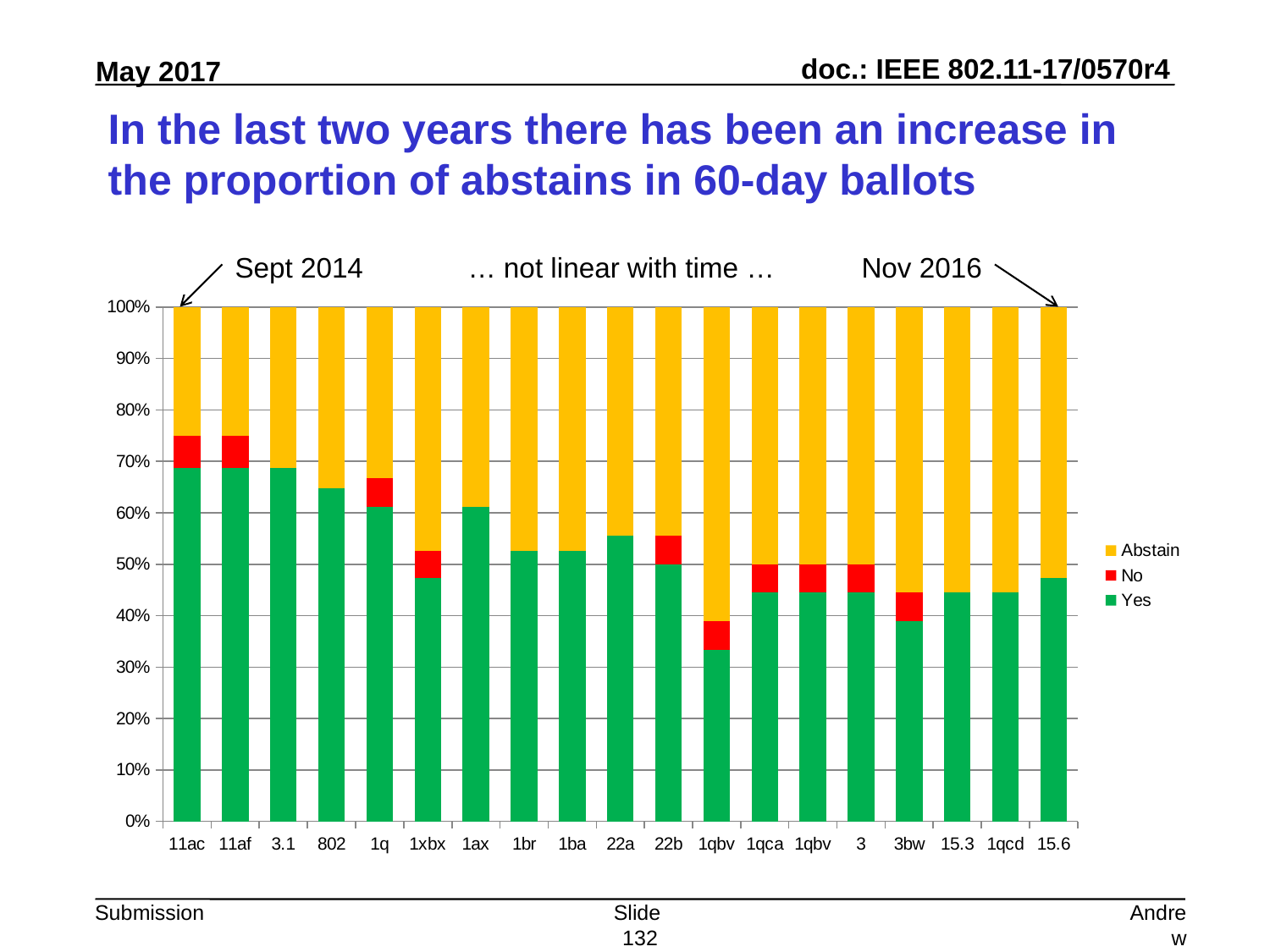
Is the Yes share for 802 greater or less than 60%? greater How many series does the chart's legend list? 3 What are the three series listed in the legend? Abstain, No, Yes Is the Yes share for 11ac greater or less than 60%? greater How many categories are shown along the x axis of the chart? 19 Which has the larger Yes share, 11ac or 1qbv? 11ac Which category has the lowest Yes share? 1qbv What is the total of the stacked bar for 15.6? 100% Is the Yes share for 1xbx greater or less than 50%? less Which category has the largest Abstain share? 1qbv What kind of chart is shown on the slide? Stacked bar chart Which colour represents the Abstain series? Yellow